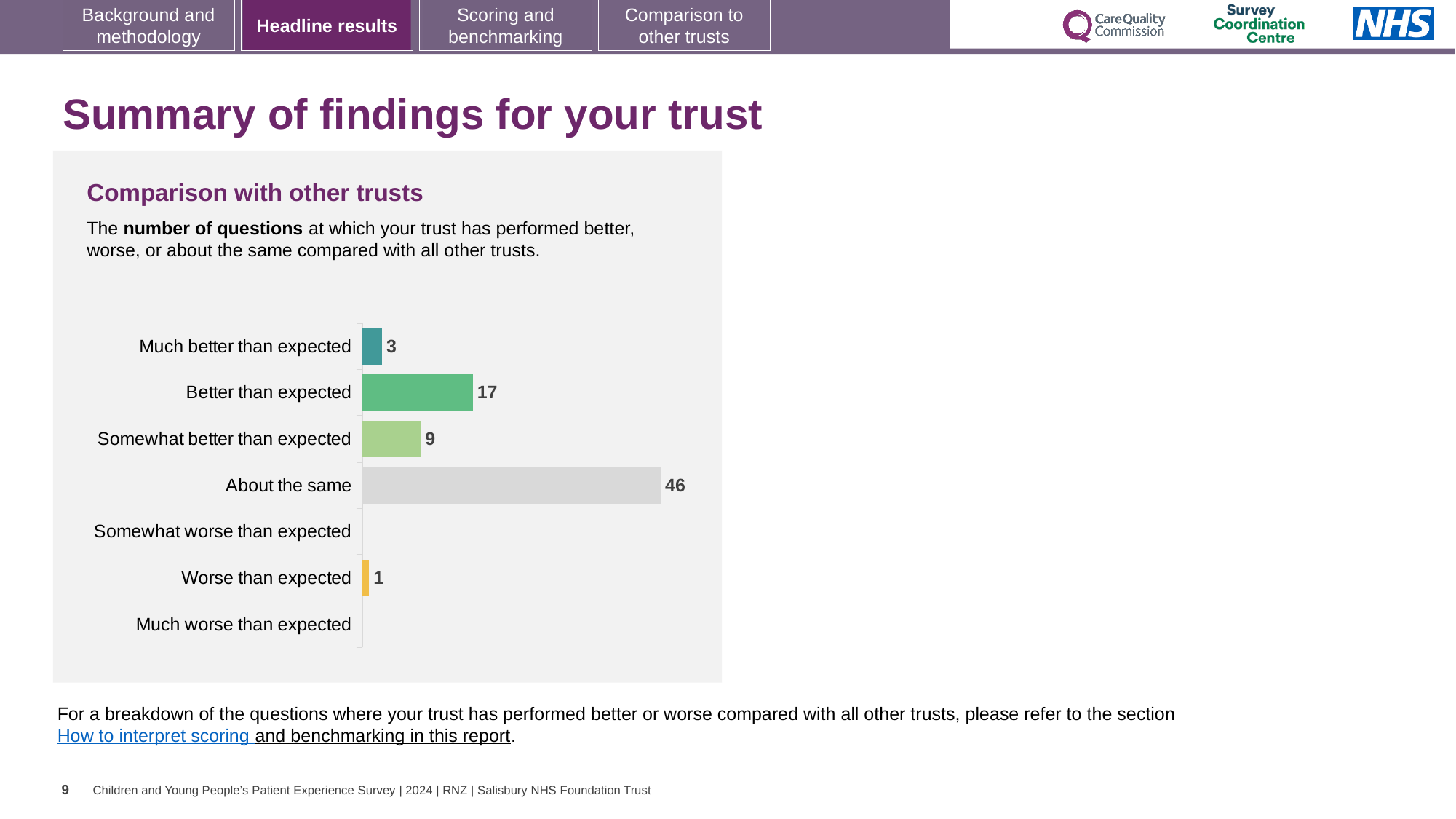
How many categories are listed on the chart? 7 Which category has the highest value? About the same What is the difference between 'Better than expected' and 'Somewhat better than expected'? 8 What is the value for 'Worse than expected'? 1 Which is larger, 'Somewhat better than expected' or 'Much better than expected'? Somewhat better than expected What is the value for 'Better than expected'? 17 What is the title of the chart? Comparison with other trusts What kind of chart is shown? Bar chart What is the difference between 'About the same' and 'Better than expected'? 29 What is the value for 'Much better than expected'? 3 What is the value for 'About the same'? 46 What colour is the bar for 'About the same'? Grey